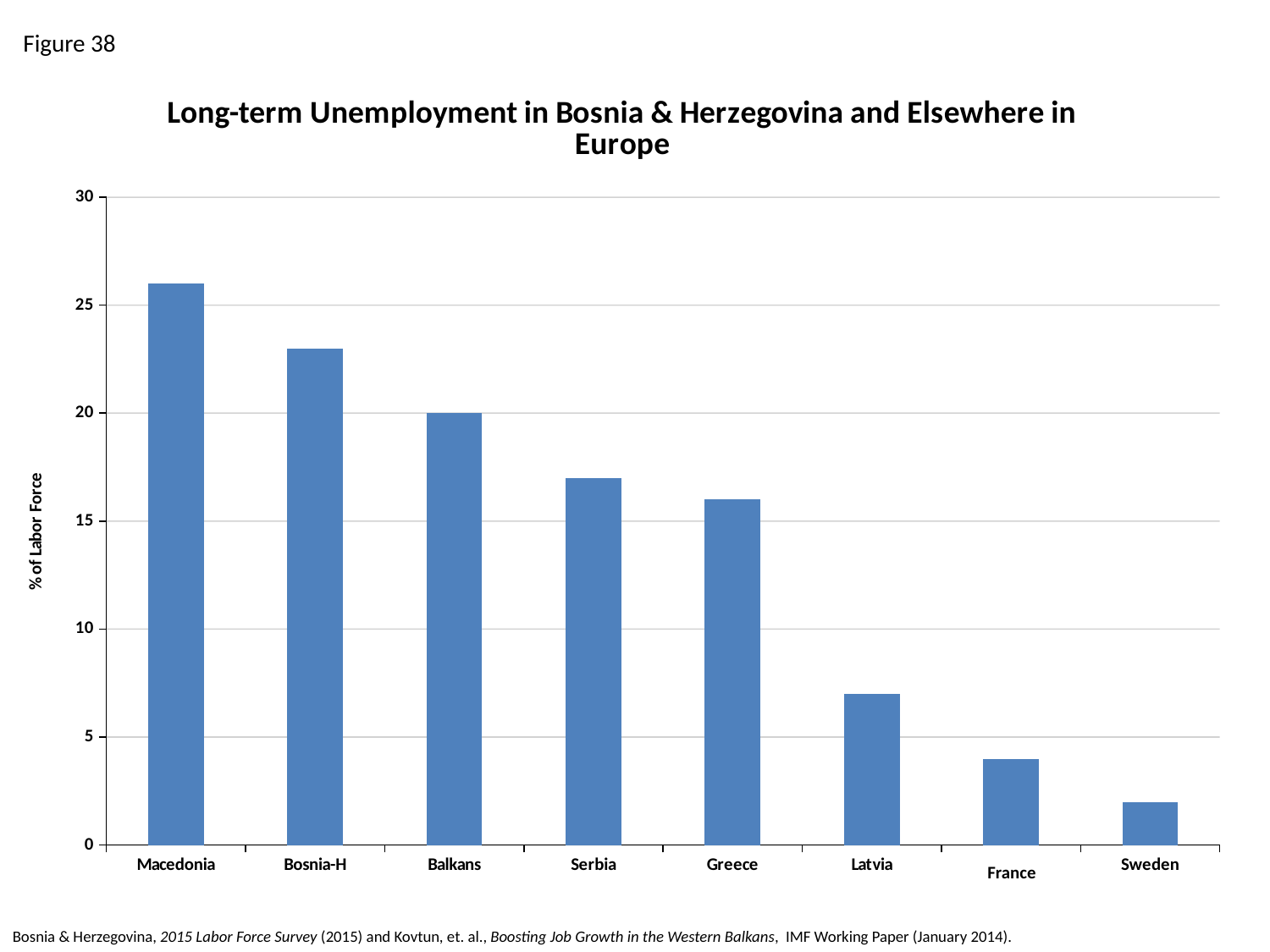
What is the label on the vertical axis of the chart? % of Labor Force What kind of chart is shown on the slide? bar chart Which has a higher long-term unemployment rate, Bosnia-H or Greece? Bosnia-H Is the value for Bosnia-H greater or less than 25? less Which country has the lowest long-term unemployment in the chart? Sweden What is the long-term unemployment value for Balkans, as a % of labor force? 20 Is the value for Serbia greater or less than 15? greater How many countries or regions are shown on the x axis of the chart? 8 Is the value for Macedonia greater or less than 25? greater Do the values rise or fall moving from left to right along the x axis? fall Which country or region has the highest long-term unemployment in the chart? Macedonia